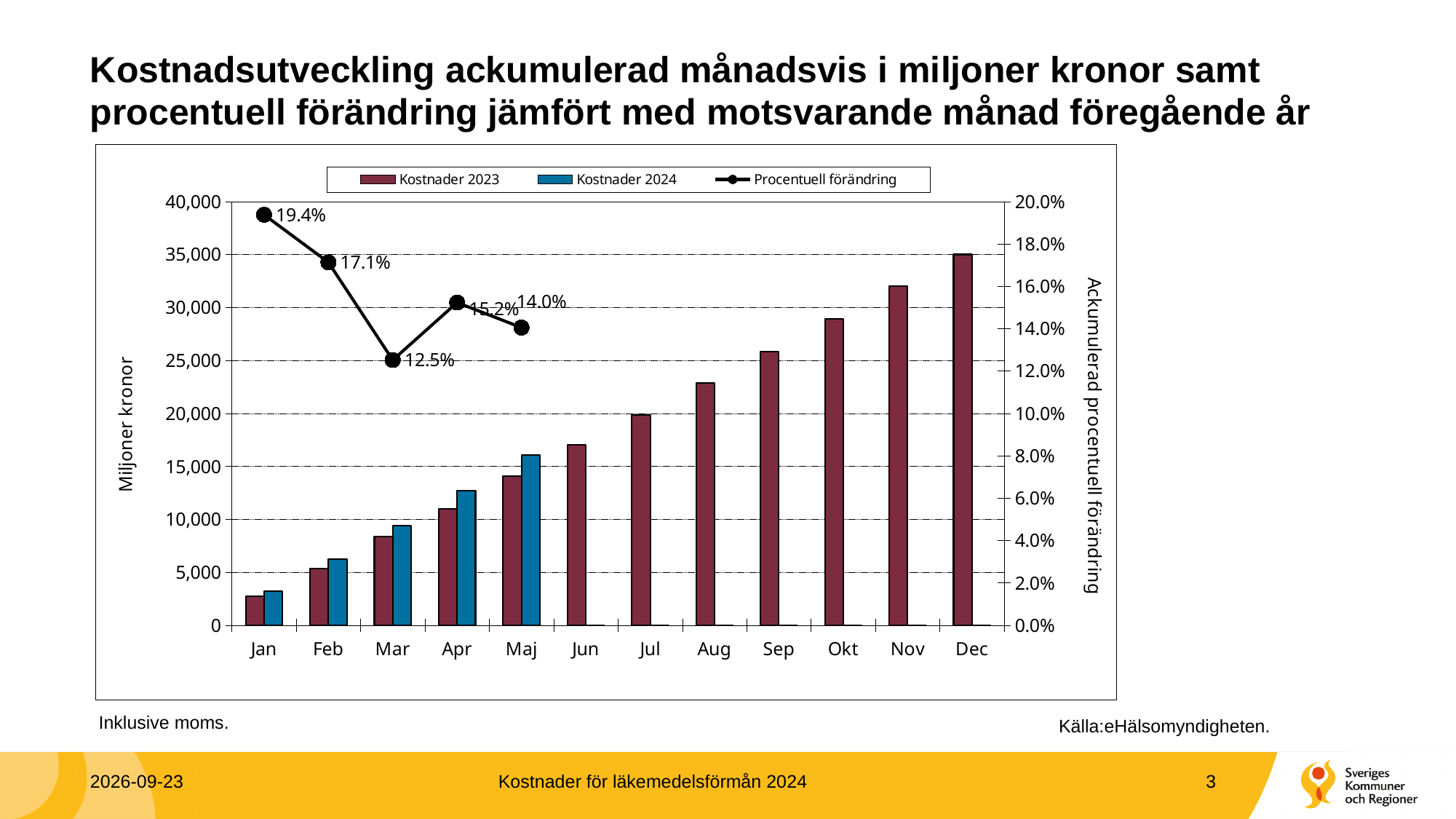
Do the Kostnader 2023 bars rise or fall from Jan to Dec? rise What is the Procentuell förändring value for Mar? 12.5% In which month is the Procentuell förändring highest? Jan What is the difference in Procentuell förändring between Jan and Feb? 2.3 percentage points In which month is the Procentuell förändring lowest? Mar Is the Kostnader 2024 value for Maj greater or less than 15,000? greater What is the Procentuell förändring value for Maj? 14.0% What is the Procentuell förändring value for Jan? 19.4% How many months are shown on the x axis? 12 Which month has the larger Procentuell förändring, Apr or Maj? Apr Is the Kostnader 2023 value for Dec greater or less than 30,000? greater How many series does the legend list? 3